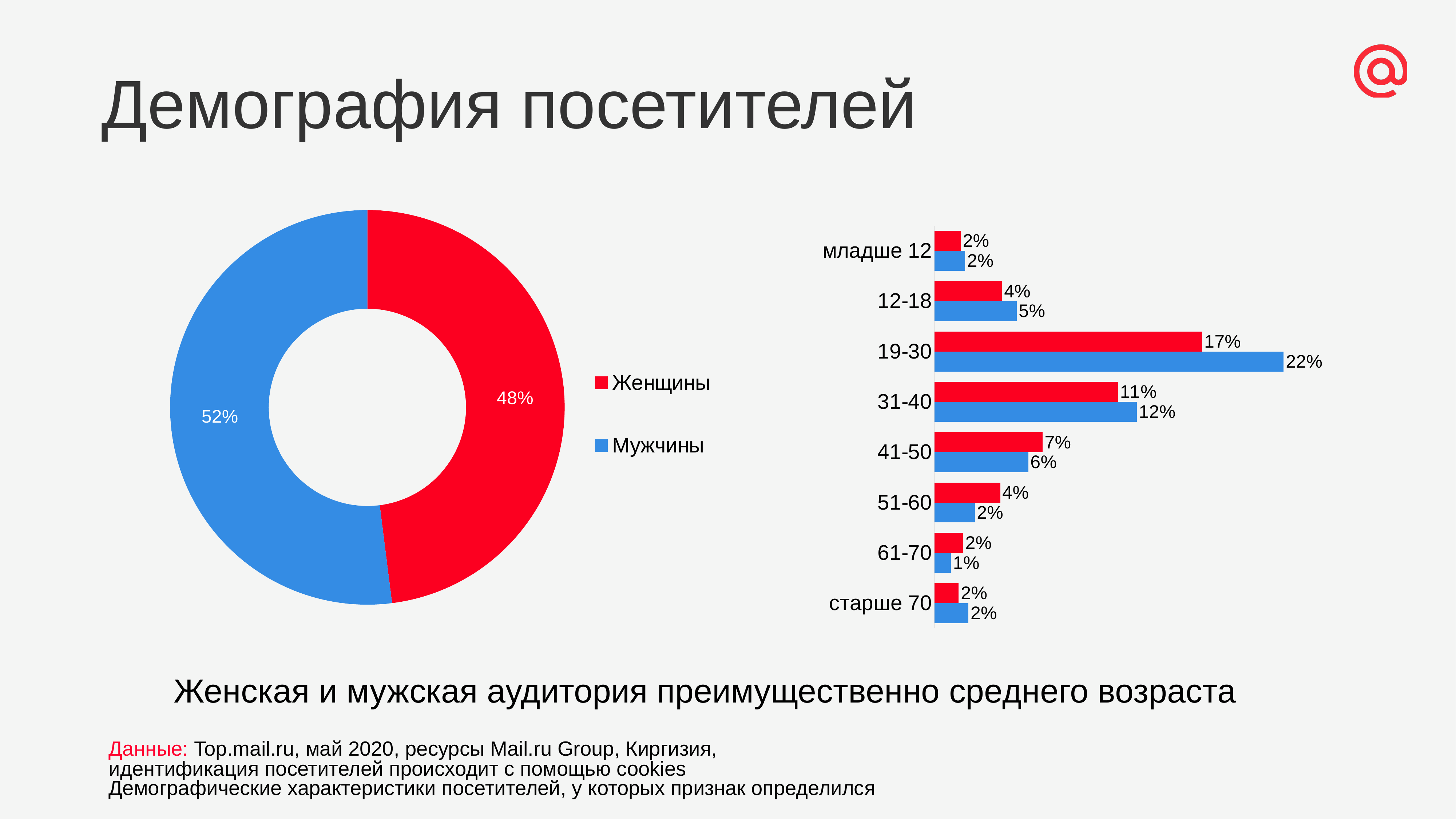
In the bar chart on the right, what is the value of the red bar for the 31-40 age group? 11% How many entries does the legend of the pie chart on the left list? 2 In the bar chart on the right, what is the value of the blue bar for the 19-30 age group? 22% What kind of chart is the chart on the left of the slide? Pie chart (donut) In the bar chart on the right, which age group has the highest value for the red bars? 19-30 In the bar chart on the right, what is the difference between the blue bar and the red bar for the 19-30 age group? 5% In the pie chart on the left, what share is labelled for Женщины? 48% In the bar chart on the right, which age group has the lowest value for the blue bars? 61-70 What kind of chart is the chart on the right of the slide? Bar chart In the pie chart on the left, what share is labelled for Мужчины? 52% In the pie chart on the left, which segment is larger, Женщины or Мужчины? Мужчины How many age groups are shown in the bar chart on the right? 8